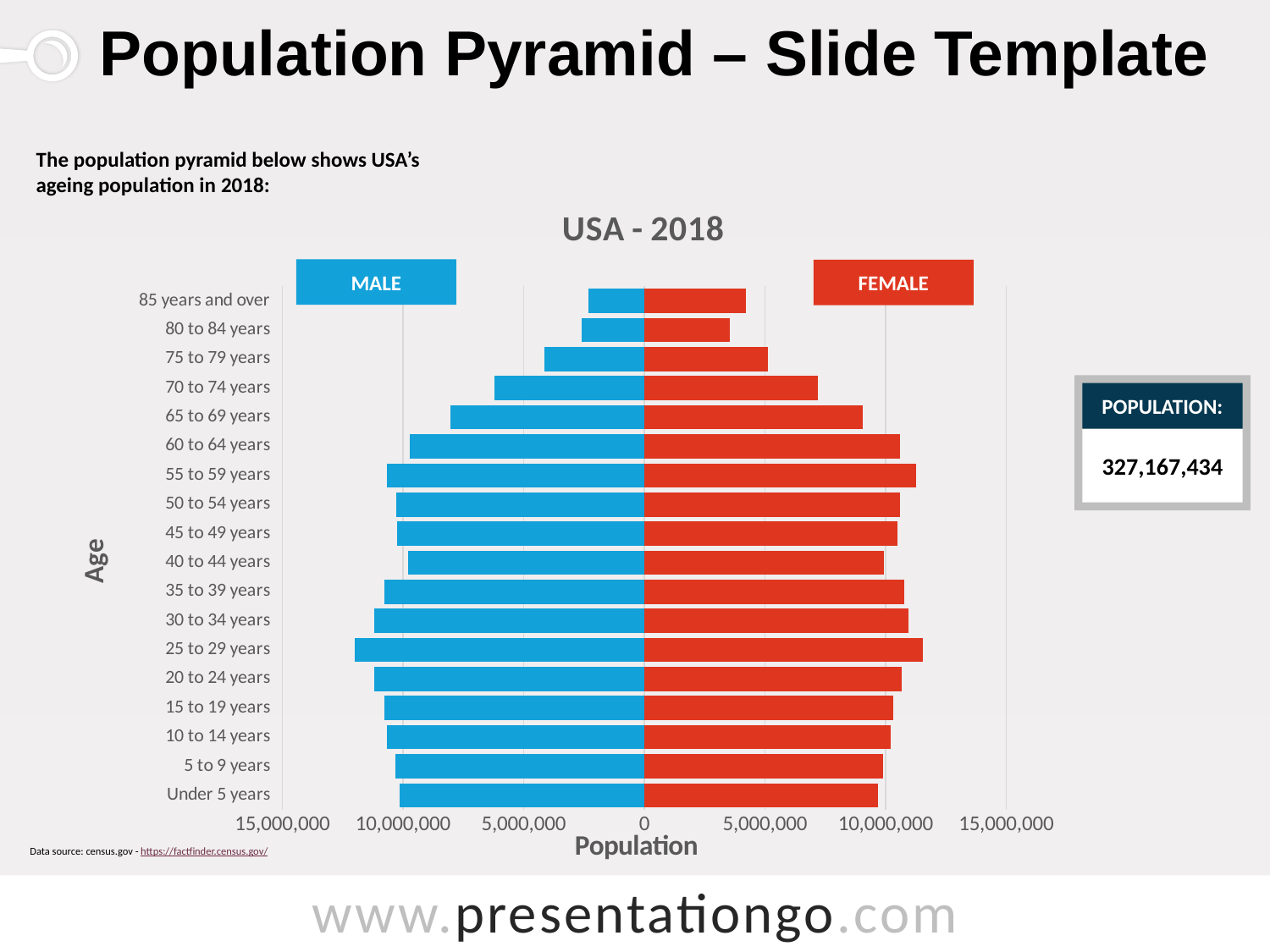
Is the MALE value for 65 to 69 years greater or less than 10,000,000? less How many age groups are plotted on the chart? 18 How many series does the chart show? 2 Is the MALE value for 25 to 29 years greater or less than 10,000,000? greater Is the MALE value for 85 years and over greater or less than 5,000,000? less Which age group has the highest MALE value? 25 to 29 years For 85 years and over, which is larger, the MALE value or the FEMALE value? FEMALE What is the title of the chart? USA - 2018 Which age group has the lowest FEMALE value? 80 to 84 years What kind of chart is shown on the slide? bar chart What is the label on the horizontal axis of the chart? Population